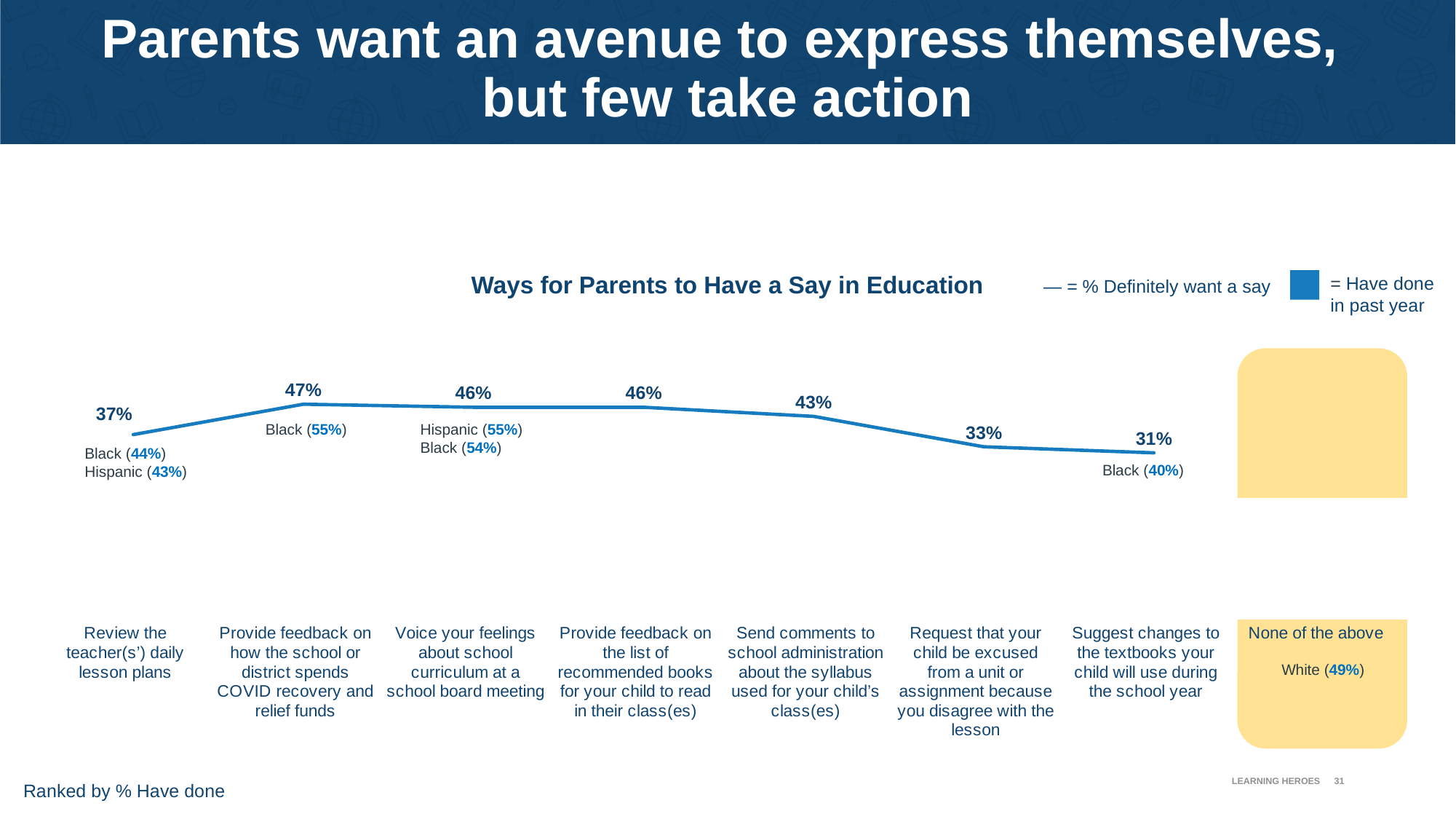
What is the % Definitely want a say value for suggesting changes to the textbooks your child will use during the school year? 31% What is the difference in % Definitely want a say between providing feedback on COVID recovery spending and suggesting changes to textbooks? 16% What is the % Definitely want a say value for providing feedback on how the school or district spends COVID recovery and relief funds? 47% How many ways for parents to have a say are plotted on the line (excluding 'None of the above')? 7 What percentage of parents definitely want a say in reviewing the teacher(s') daily lesson plans? 37% What percentage of Black parents definitely want a say in providing feedback on how the school or district spends COVID recovery and relief funds? 55% What kind of chart is used to show the % Definitely want a say values? Line chart Which has a higher % Definitely want a say: sending comments to school administration about the syllabus, or requesting that your child be excused from a unit or assignment? Send comments to school administration about the syllabus What is the title of the chart? Ways for Parents to Have a Say in Education From 'Provide feedback on the list of recommended books' to 'Suggest changes to the textbooks', does the % Definitely want a say line rise or fall? Fall Which way for parents to have a say has the highest % Definitely want a say? Provide feedback on how the school or district spends COVID recovery and relief funds Which way for parents to have a say has the lowest % Definitely want a say? Suggest changes to the textbooks your child will use during the school year